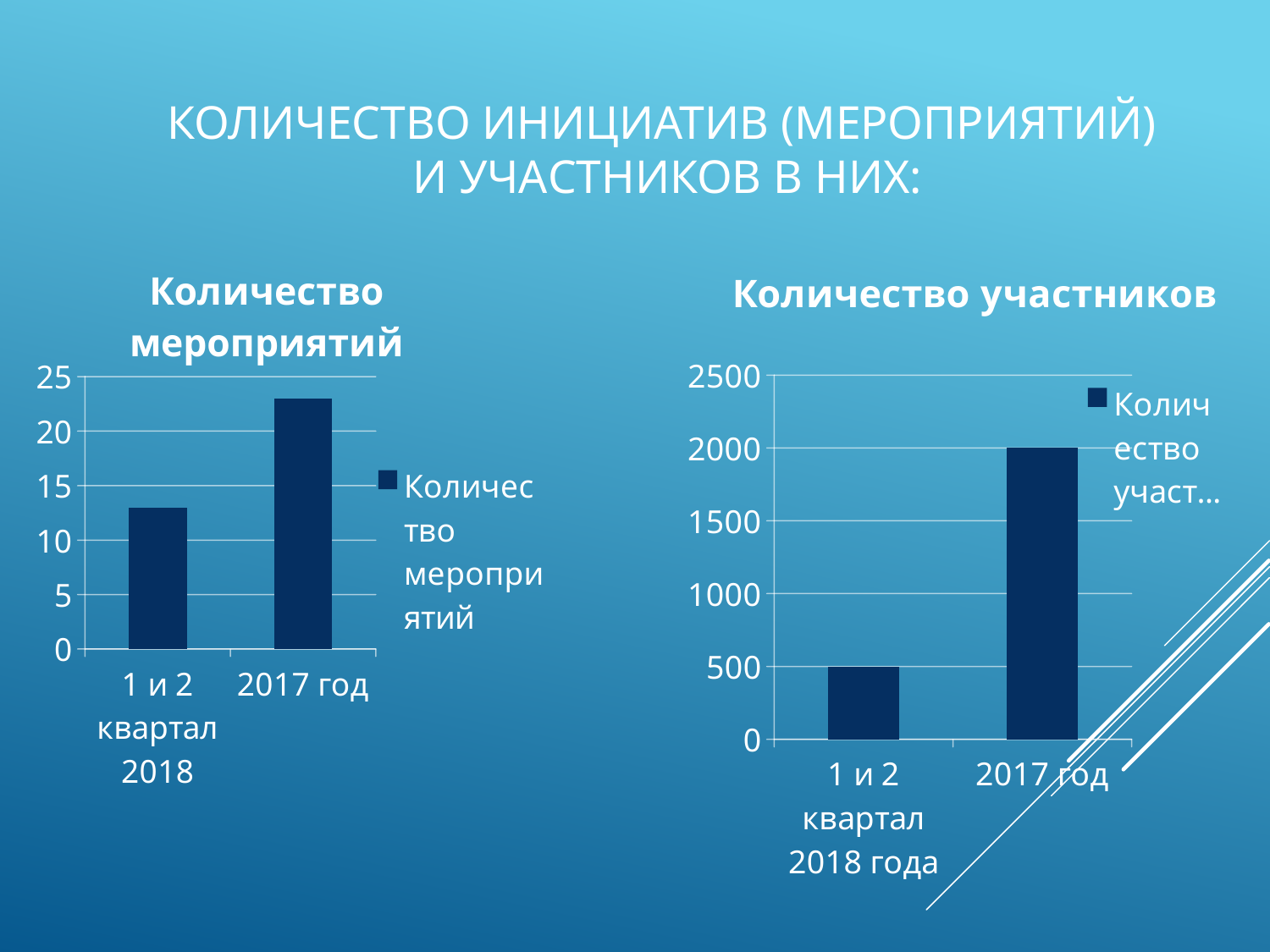
In the chart titled "Количество мероприятий", which category has the lowest value? 1 и 2 квартал 2018 In the chart titled "Количество мероприятий", is the value for "2017 год" greater or less than 20? greater What is the title of the chart on the right side of the slide? Количество участников In the chart titled "Количество участников", what is the value for "1 и 2 квартал 2018 года"? 500 How many categories are shown in the chart titled "Количество участников"? 2 How many series does the legend of the chart titled "Количество мероприятий" list? 1 What kind of chart is the chart titled "Количество мероприятий"? Bar chart In the chart titled "Количество мероприятий", which is larger: the value for "2017 год" or the value for "1 и 2 квартал 2018"? 2017 год In the chart titled "Количество мероприятий", is the value for "1 и 2 квартал 2018" greater or less than 15? less In the chart titled "Количество участников", what is the difference between the values for "2017 год" and "1 и 2 квартал 2018 года"? 1500 In the chart titled "Количество участников", what is the value for "2017 год"? 2000 In the chart titled "Количество участников", which category has the highest value? 2017 год